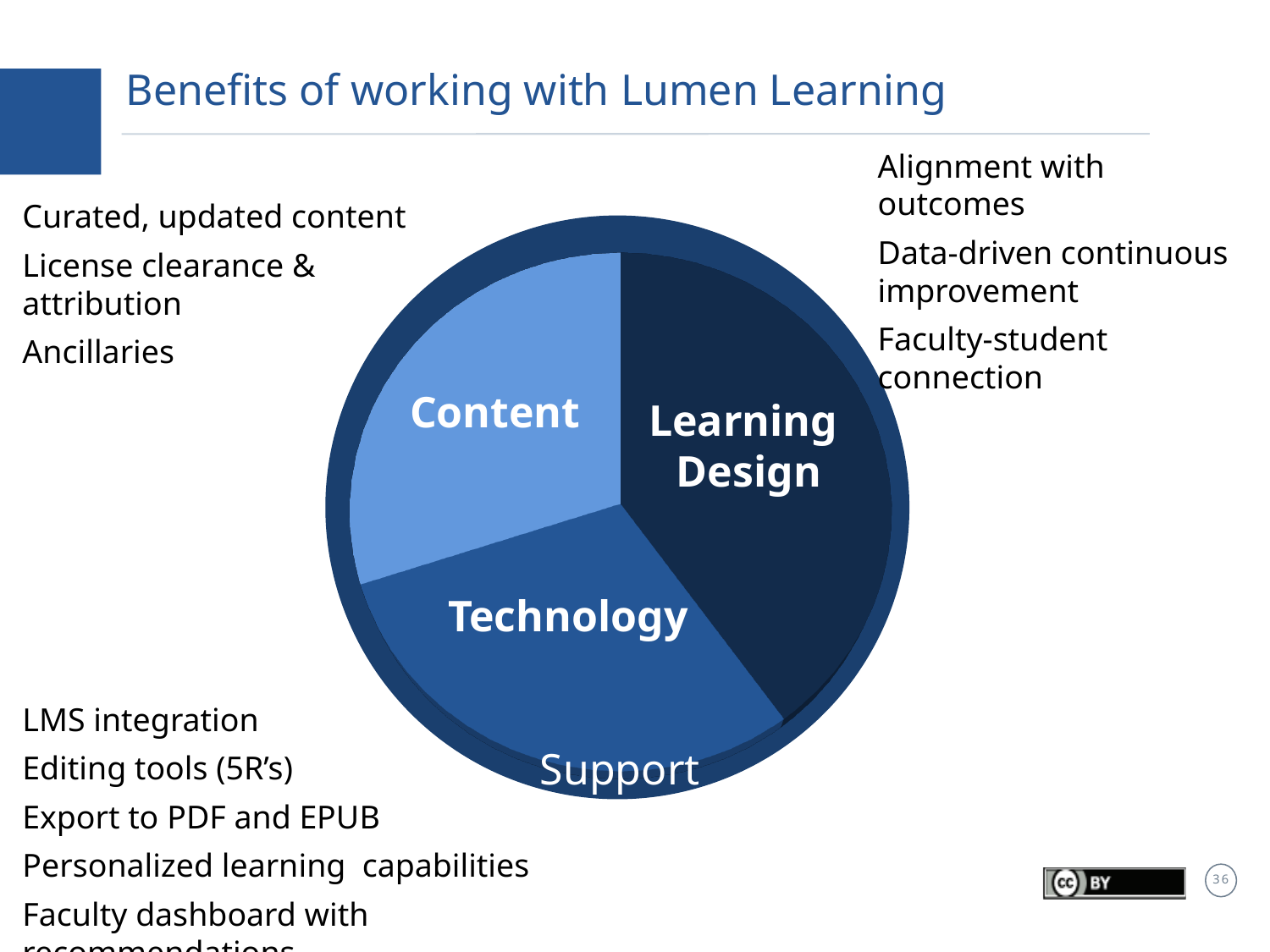
Which slice is larger, Learning Design or Content? Learning Design What kind of chart is shown on the slide? pie chart What is the title of the slide containing the pie chart? Benefits of working with Lumen Learning Which slice is larger, Learning Design or Technology? Learning Design How many slices does the pie chart have? 3 Which slice of the pie chart is shown in the lightest blue? Content What are the labels of the three slices in the pie chart? Content, Learning Design, Technology Which slice of the pie chart is the largest? Learning Design